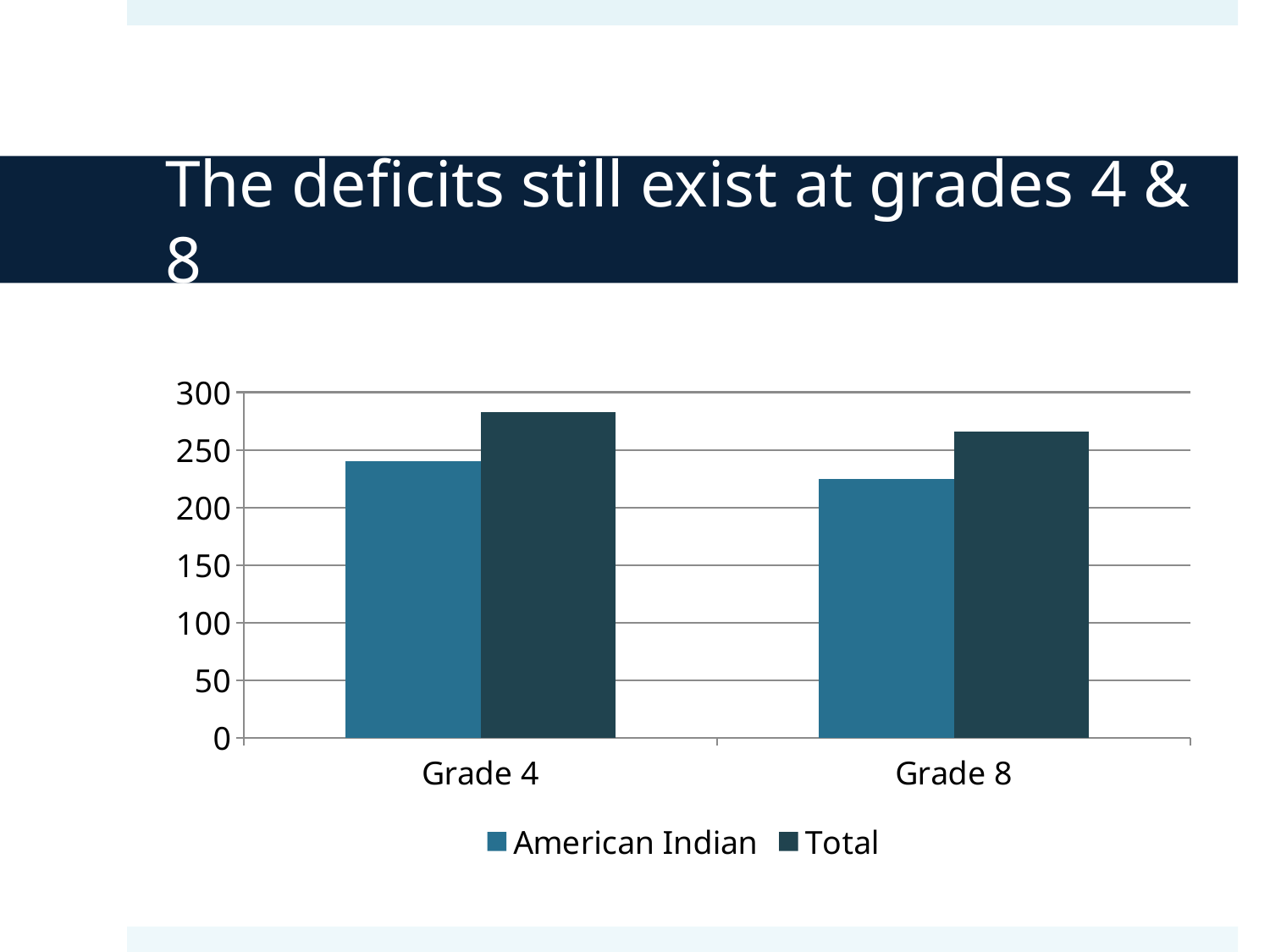
Is the Total value for Grade 8 greater or less than 250? greater What kind of chart is shown on the slide? bar chart Which grade has the higher American Indian value, Grade 4 or Grade 8? Grade 4 How many series does the legend list? 2 How many grade categories are shown on the x axis? 2 Is the American Indian value for Grade 4 greater or less than 200? greater Does the Total value rise or fall from Grade 4 to Grade 8? fall Which series has the higher value at Grade 4, American Indian or Total? Total Is the Total value for Grade 4 greater or less than 250? greater Which bar is the tallest in the chart? Total at Grade 4 Which bar is the shortest in the chart? American Indian at Grade 8